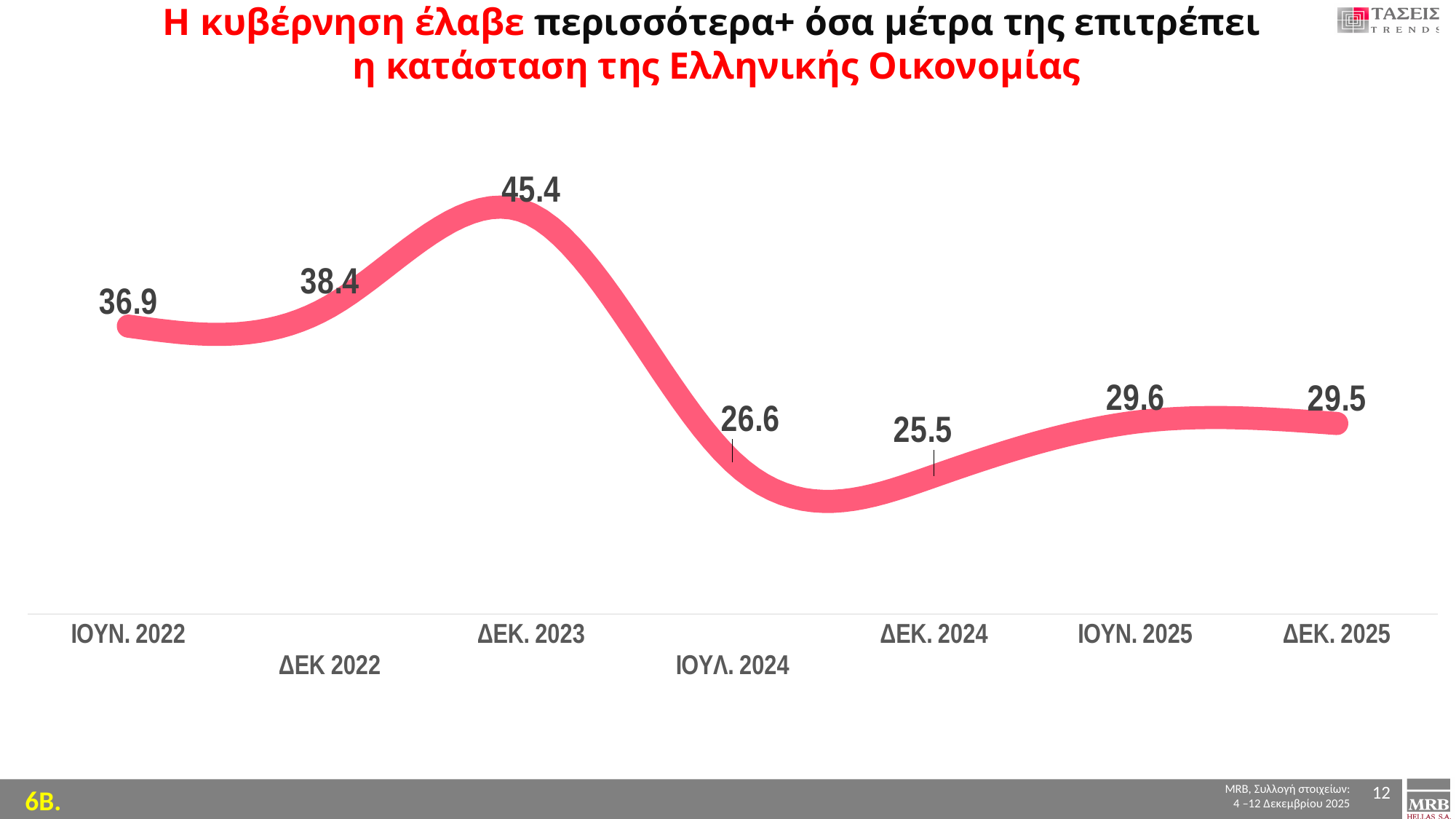
Which time point has the highest value? ΔΕΚ. 2023 What kind of chart is shown on the slide? line chart What is the difference between the values for ΔΕΚ 2022 and ΙΟΥΝ. 2022? 1.5 What is the difference between the values for ΔΕΚ. 2023 and ΔΕΚ. 2024? 19.9 What is the value for ΔΕΚ. 2023? 45.4 What is the value for ΔΕΚ. 2025? 29.5 What is the value for ΙΟΥΛ. 2024? 26.6 Which time point has the lowest value? ΔΕΚ. 2024 How many time points are plotted on the chart? 7 What is the value for ΙΟΥΝ. 2022? 36.9 Does the value rise or fall from ΔΕΚ. 2023 to ΙΟΥΛ. 2024? fall Which is larger, the value for ΔΕΚ 2022 or the value for ΙΟΥΝ. 2025? ΔΕΚ 2022